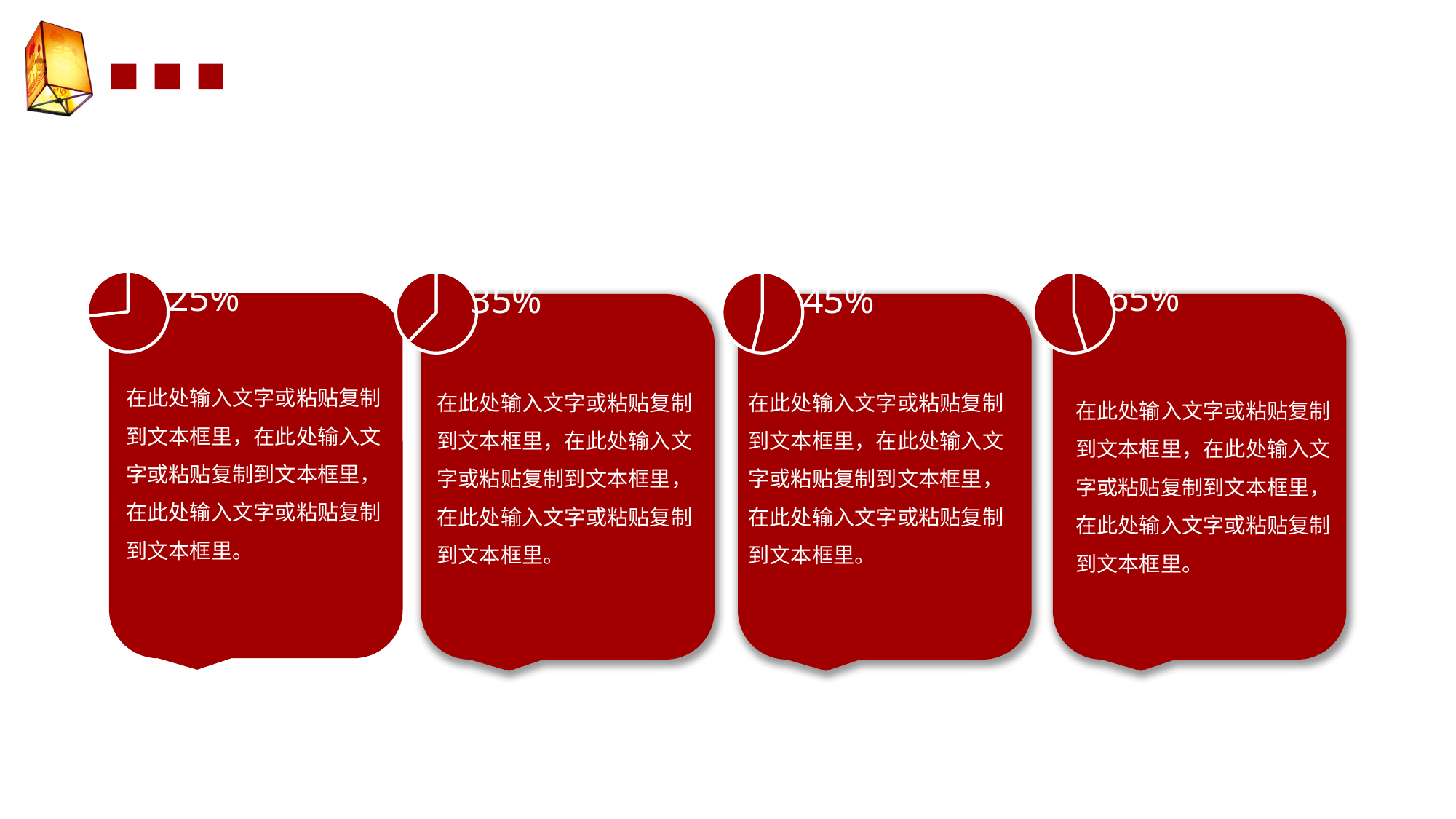
What percentage is shown next to the third pie chart from the left? 45% What percentage is shown next to the fourth (rightmost) pie chart? 65% Which is larger, the percentage of the second pie chart or the third pie chart? The third pie chart (45%) What is the difference between the percentages of the second and third pie charts? 10% Do the percentages increase or decrease from the leftmost pie chart to the rightmost? Increase Which pie chart shows the highest percentage? The fourth (rightmost), 65% What is the difference between the percentage of the rightmost pie chart and the leftmost pie chart? 40% How many pie charts are on the slide? 4 What kind of chart is used to show each percentage on the slide? Pie chart What percentage is shown next to the first (leftmost) pie chart? 25% What percentage is shown next to the second pie chart from the left? 35% Which pie chart shows the lowest percentage? The first (leftmost), 25%